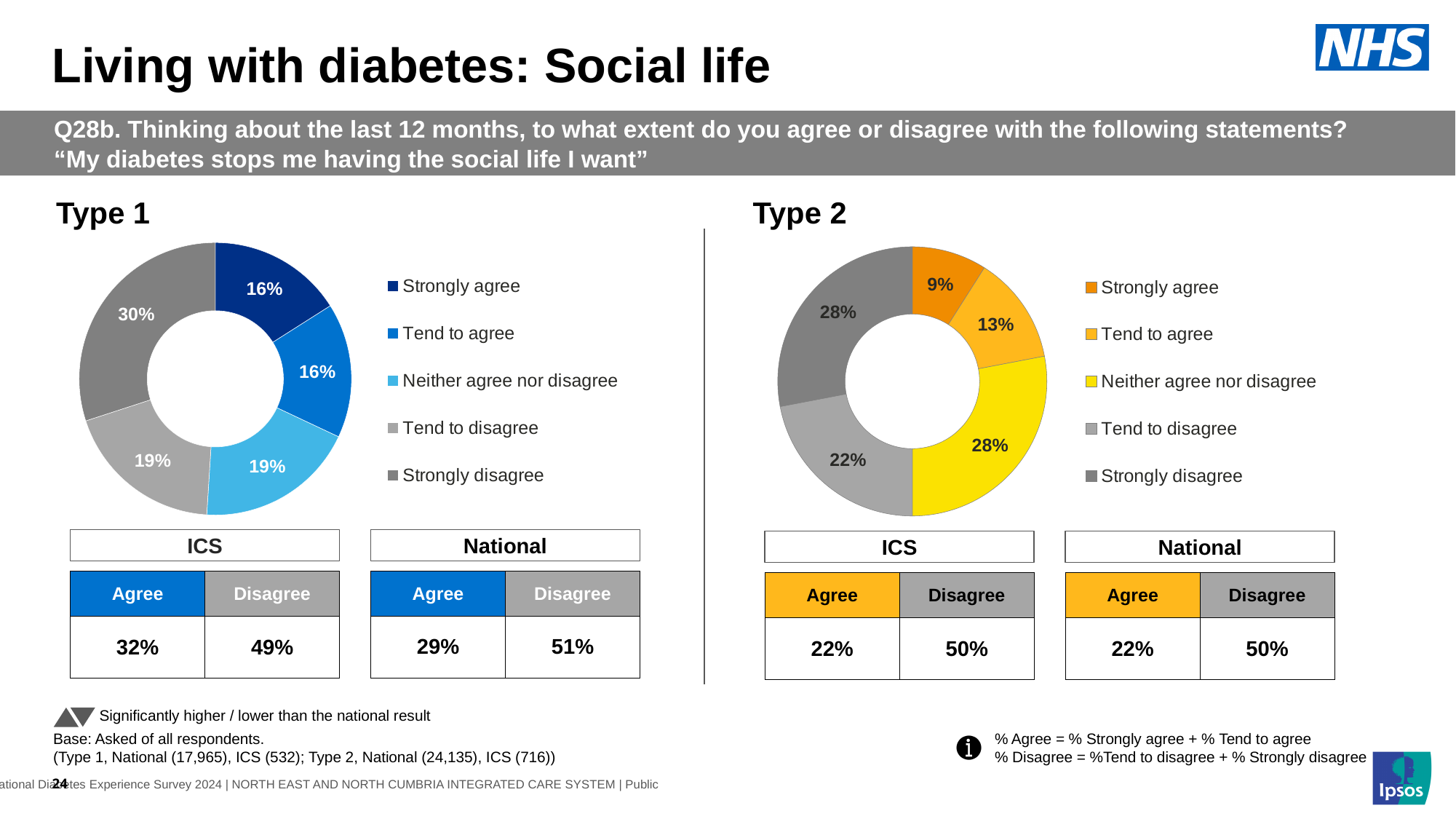
In the Type 2 chart, what is the difference between the Tend to disagree share and the Tend to agree share? 9 percentage points In the Type 2 chart, what percentage of respondents tend to agree? 13% In the Type 1 chart, which response category has the largest share? Strongly disagree In the Type 1 chart, what percentage of respondents strongly disagree? 30% In the Type 2 chart, which response category has the smallest share? Strongly agree In the Type 2 chart, which is larger: the Strongly agree share or the Tend to disagree share? Tend to disagree In the Type 1 chart, what is the difference between the Strongly disagree share and the Strongly agree share? 14 percentage points How many response categories does the Type 1 chart show? 5 In the Type 1 chart, what is the combined share of Strongly agree and Tend to agree? 32% In the Type 2 chart, what percentage of respondents neither agree nor disagree? 28% What colour represents Strongly agree in the Type 2 chart? Orange What kind of chart is used for Type 2? Donut (pie) chart